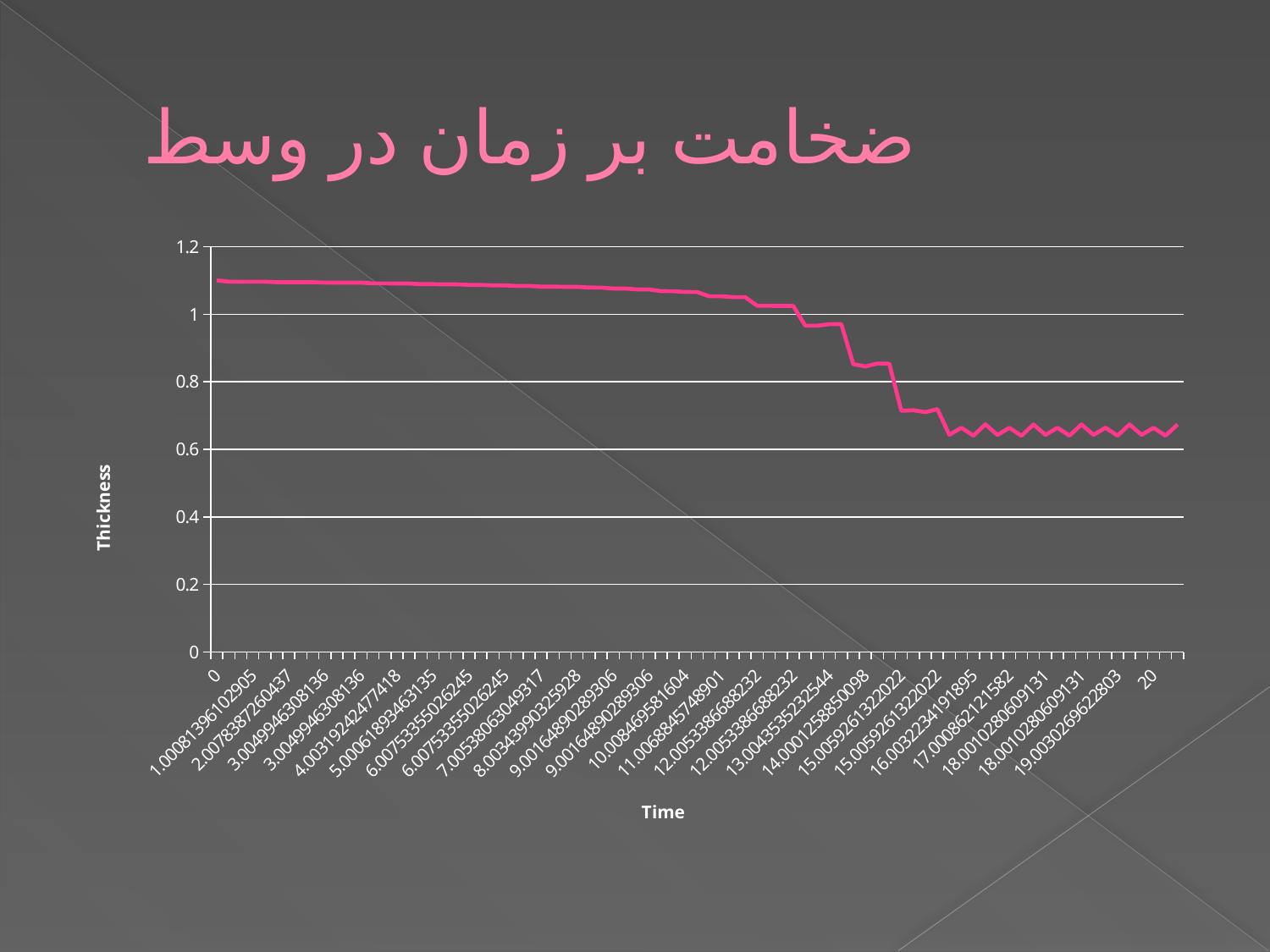
Is the Thickness value at Time 10.0084695816604 greater or less than 1? greater Is the Thickness value at Time 20 greater or less than 0.6? greater At which Time value is the Thickness highest? 0 Is the Thickness value at Time 15.0059261322022 greater or less than 1? less What is the title of the vertical axis? Thickness What kind of chart is shown on the slide? line chart Does the Thickness value generally rise or fall as Time increases along the x axis? fall Is the Thickness value at Time 0 larger or smaller than the value at Time 20? larger What is the title of the horizontal axis? Time